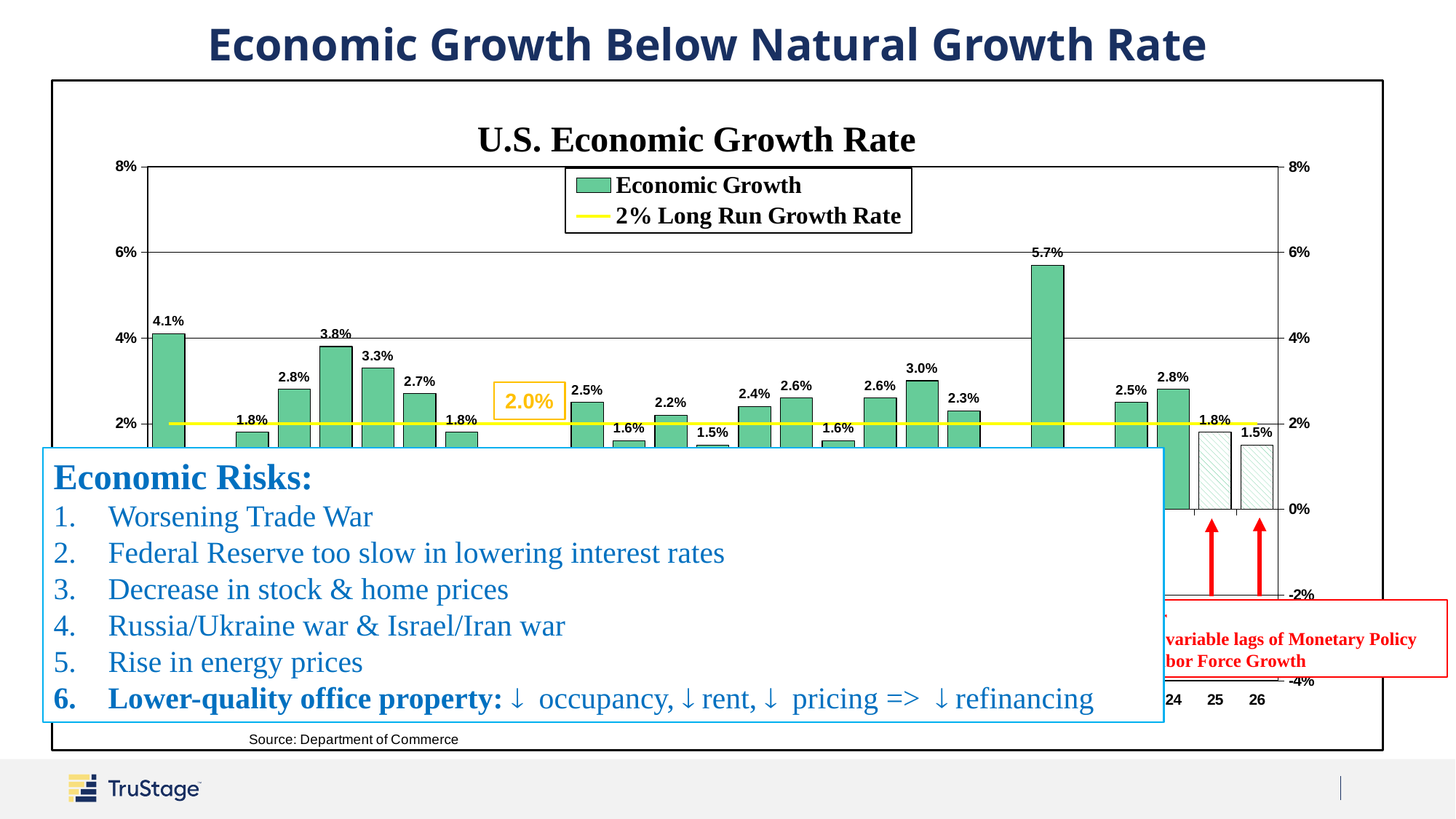
In the U.S. Economic Growth Rate chart, do the economic growth values rise or fall from 24 to 26? fall In the U.S. Economic Growth Rate chart, which has the larger economic growth value, 24 or 25? 24 What value does the yellow line in the U.S. Economic Growth Rate chart represent, according to the legend? 2% Long Run Growth Rate In the U.S. Economic Growth Rate chart, which of 24, 25 and 26 has the lowest economic growth value? 26 What is the highest economic growth value labeled in the U.S. Economic Growth Rate chart? 5.7% In the U.S. Economic Growth Rate chart, is the economic growth value for 26 greater or less than 2%? less What type of chart is the U.S. Economic Growth Rate chart? Combination bar and line chart How many series does the legend of the U.S. Economic Growth Rate chart list? 2 In the U.S. Economic Growth Rate chart, what is the difference between the economic growth values for 25 and 26? 0.3% In the U.S. Economic Growth Rate chart, what is the economic growth value for 24? 2.8% In the U.S. Economic Growth Rate chart, what is the economic growth value for 26? 1.5% In the U.S. Economic Growth Rate chart, what is the economic growth value for 25? 1.8%